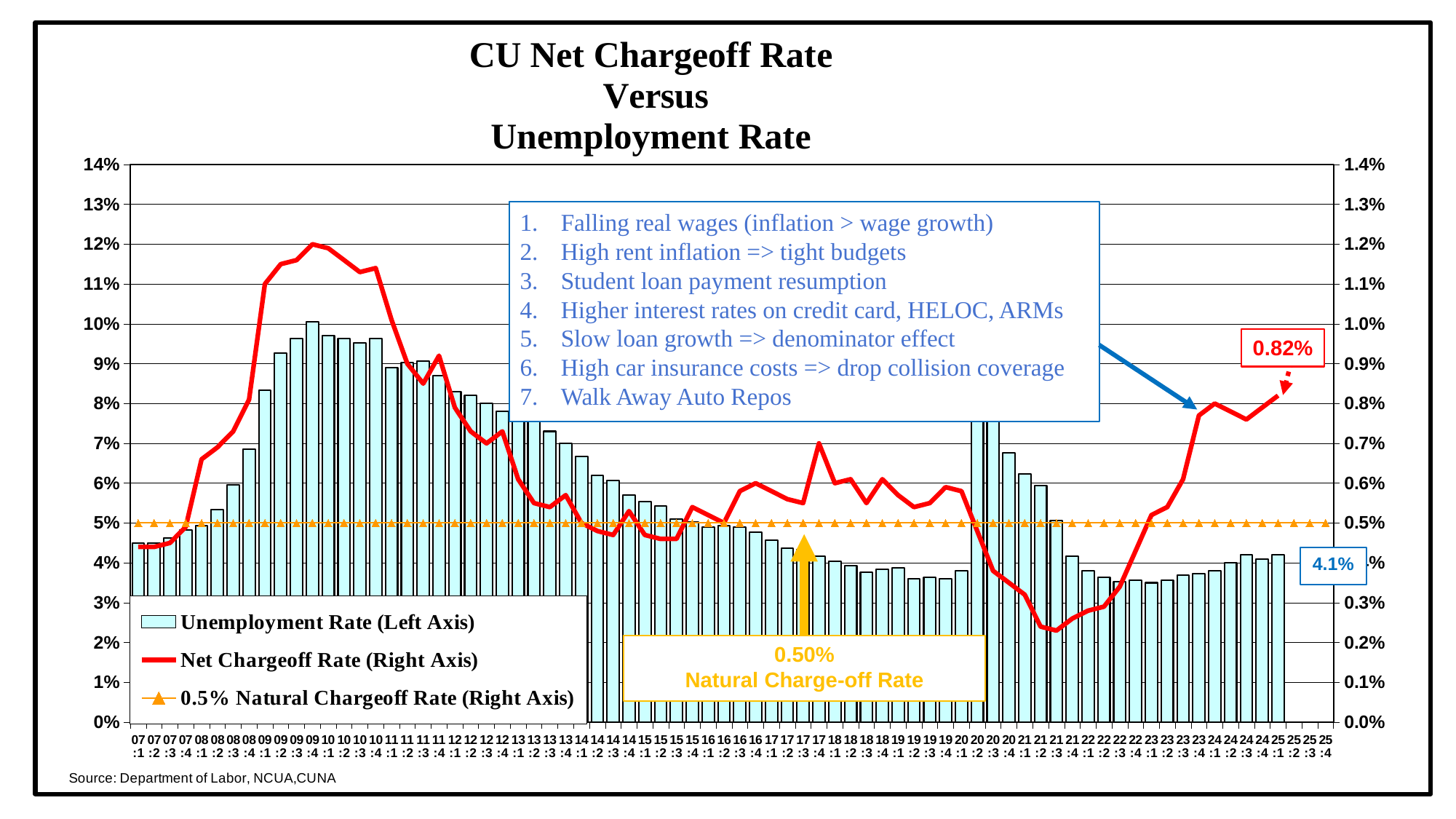
What is the most recent Net Chargeoff Rate value labeled on the chart? 0.82% What value is given for the Natural Charge-off Rate? 0.50% Does the Net Chargeoff Rate rise or fall from 21:3 to 25:1? rise Which series is plotted on the left axis according to the legend? Unemployment Rate Does the Unemployment Rate rise or fall from 10:1 to 19:4? fall How many series does the legend list? 3 What is the most recent Unemployment Rate value labeled on the chart? 4.1% What kind of chart is shown on the slide? A combination bar and line chart Which is larger, the Unemployment Rate in 09:4 or in 07:1? 09:4 Is the Net Chargeoff Rate in 21:3 greater or less than 0.3%? less By how much does the labeled 0.82% Net Chargeoff Rate exceed the 0.50% Natural Charge-off Rate? 0.32% Is the Net Chargeoff Rate in 09:4 greater or less than 1.1%? greater